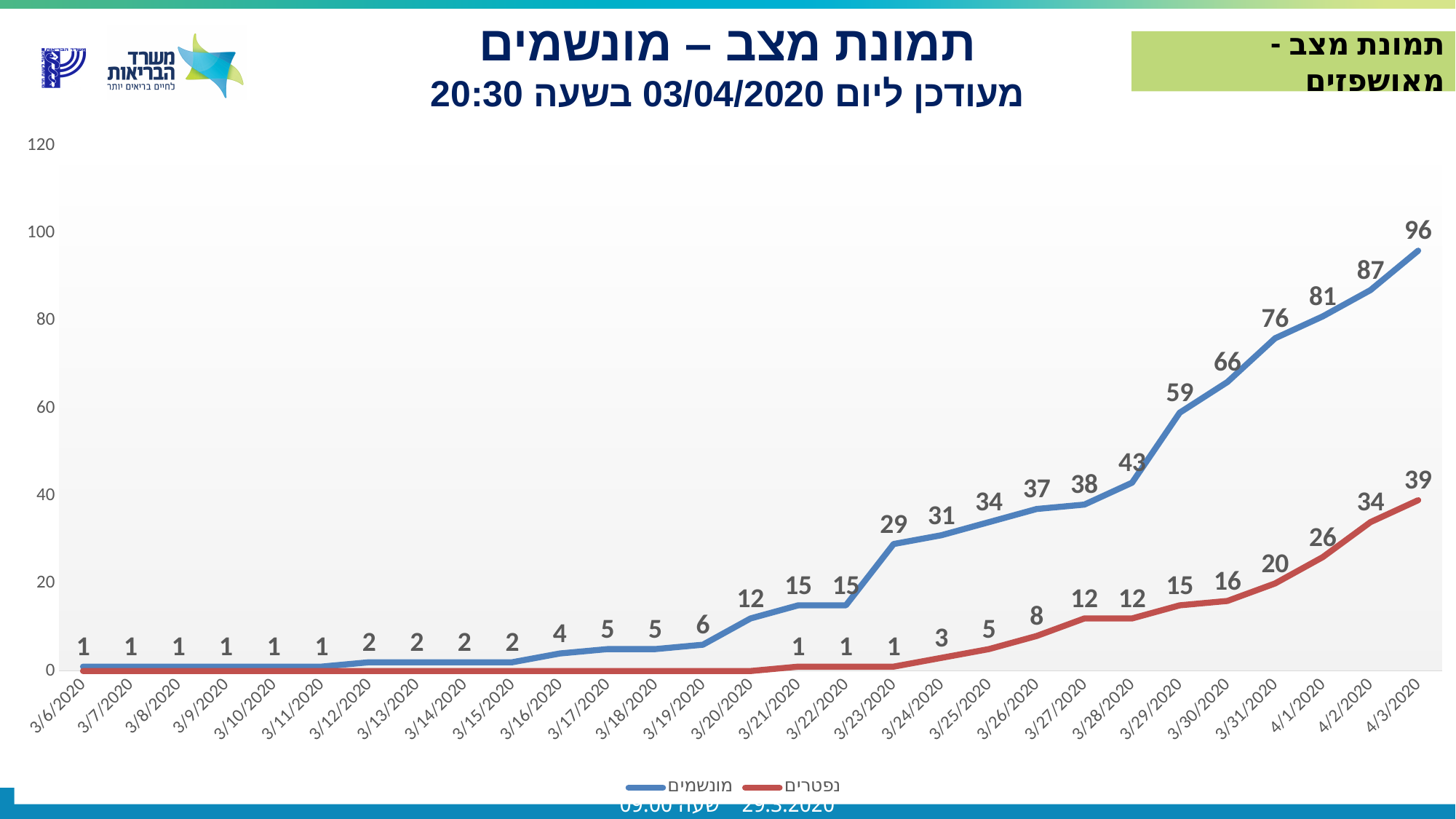
What is the difference between the מונשמים and נפטרים values on 4/3/2020? 57 Which series has the larger value on 3/31/2020, מונשמים or נפטרים? מונשמים What kind of chart is shown on the slide? Line chart What is the value of the מונשמים series on 3/23/2020? 29 What is the value of the מונשמים series on 4/3/2020? 96 How many series does the legend list? 2 What is the value of the נפטרים series on 4/3/2020? 39 By how much did the מונשמים value increase from 4/2/2020 to 4/3/2020? 9 Does the מונשמים series rise or fall from 3/6/2020 to 4/3/2020? Rises How many dates are shown on the x axis? 29 On which date does the מונשמים series reach its highest value? 4/3/2020 What is the value of the נפטרים series on 3/29/2020? 15